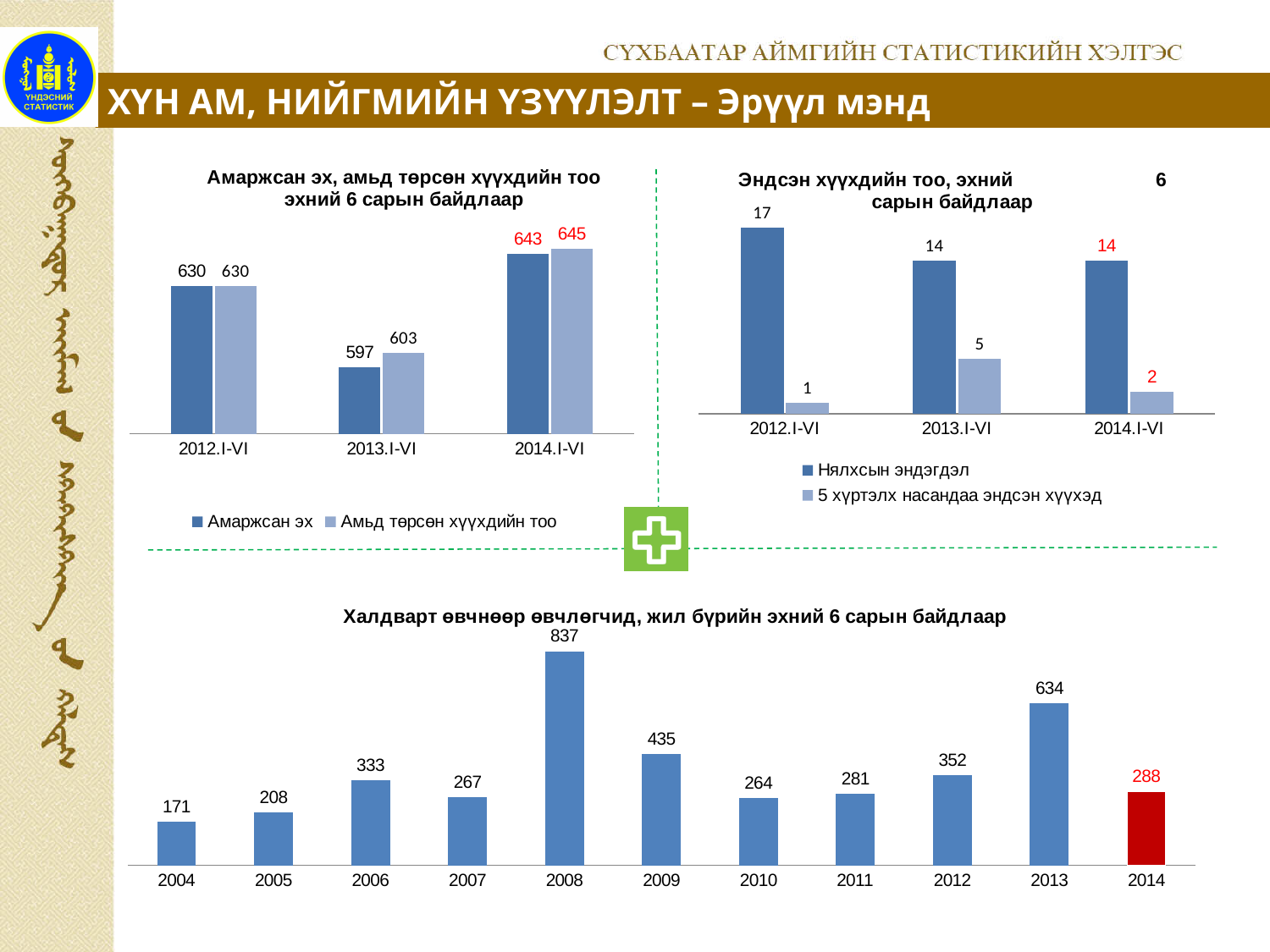
In the top-left chart (Амаржсан эх, амьд төрсөн хүүхдийн тоо), what is the value for Амьд төрсөн хүүхдийн тоо in 2013.I-VI? 603 In the top-right chart (Эндсэн хүүхдийн тоо), in which period is the value for 5 хүртэлх насандаа эндсэн хүүхэд highest? 2013.I-VI In the bottom chart (Халдварт өвчнөөр өвчлөгчид), which year has the lowest value? 2004 In the bottom chart (Халдварт өвчнөөр өвчлөгчид), what is the difference between the values for 2013 and 2014? 346 In the top-left chart (Амаржсан эх, амьд төрсөн хүүхдийн тоо), what is the difference between Амьд төрсөн хүүхдийн тоо and Амаржсан эх in 2013.I-VI? 6 In the bottom chart (Халдварт өвчнөөр өвчлөгчид), what is the value for 2012? 352 In the bottom chart (Халдварт өвчнөөр өвчлөгчид), which year has the highest value? 2008 In the top-left chart (Амаржсан эх, амьд төрсөн хүүхдийн тоо), what is the value for Амаржсан эх in 2014.I-VI? 643 In the top-right chart (Эндсэн хүүхдийн тоо), what is the difference between Нялхсын эндэгдэл and 5 хүртэлх насандаа эндсэн хүүхэд in 2014.I-VI? 12 In the top-left chart (Амаржсан эх, амьд төрсөн хүүхдийн тоо), how many series does the legend list? 2 In the top-right chart (Эндсэн хүүхдийн тоо), what is the value for Нялхсын эндэгдэл in 2012.I-VI? 17 In the bottom chart (Халдварт өвчнөөр өвчлөгчид), how many years are shown on the x axis? 11